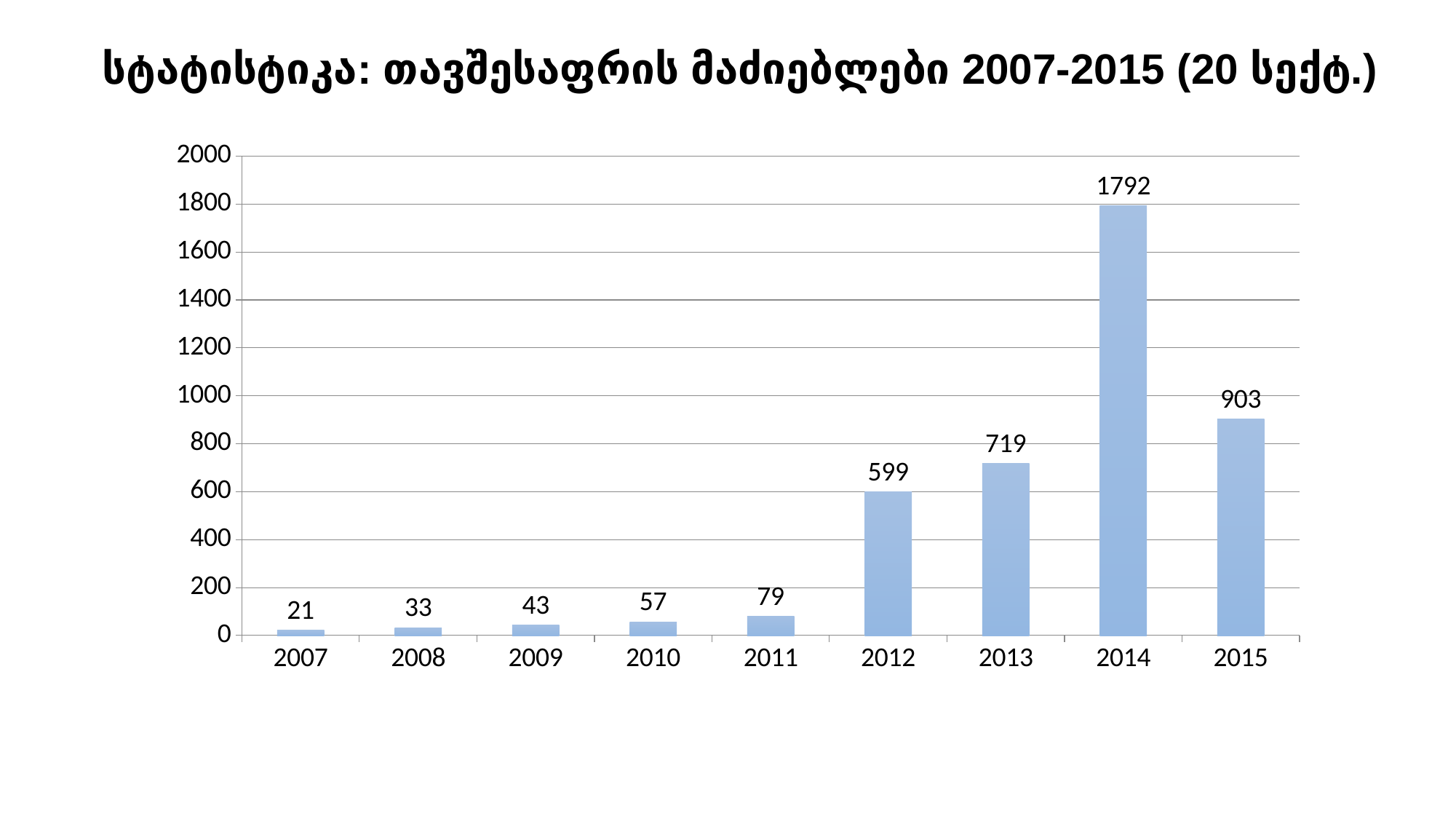
What is the difference between the values for 2014 and 2015? 889 What is the value for 2007? 21 What is the difference between the values for 2013 and 2012? 120 What is the value for 2014? 1792 Which year has the lowest value? 2007 How many years are shown on the x axis? 9 Is the value for 2015 greater or less than 1000? less Which is larger, the value for 2013 or the value for 2015? 2015 Do the values rise or fall from 2007 to 2014? rise Which year has the highest value? 2014 What is the value for 2012? 599 What kind of chart is shown on the slide? bar chart